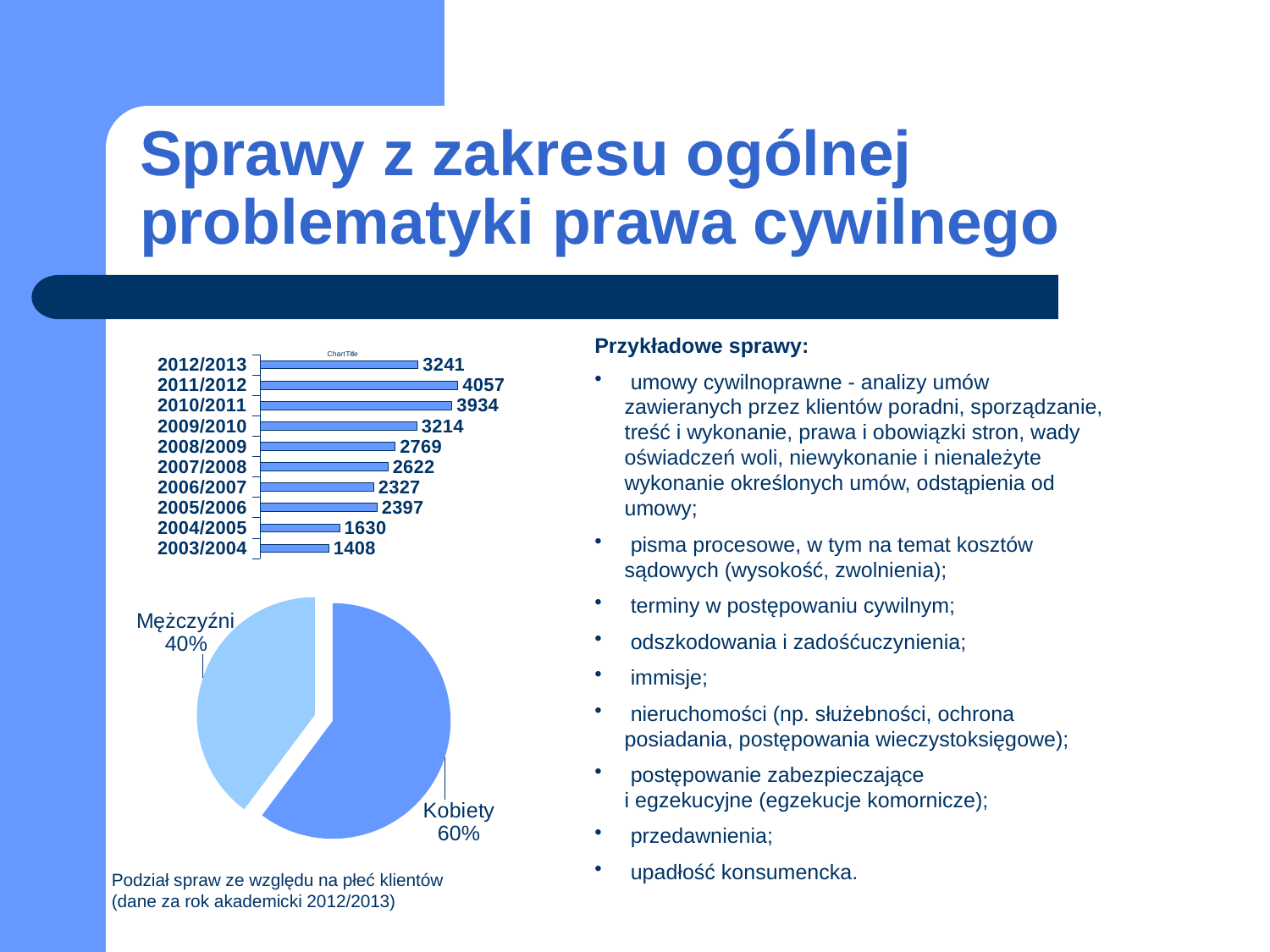
In the bar chart at the top left of the slide, what is the value for 2003/2004? 1408 How many years are shown in the bar chart at the top left of the slide? 10 In the bar chart at the top left of the slide, which is larger, the value for 2005/2006 or the value for 2006/2007? 2005/2006 In the bar chart at the top left of the slide, what is the difference between the values for 2011/2012 and 2012/2013? 816 In the pie chart at the bottom left of the slide, what share is labelled Mężczyźni? 40% In the bar chart at the top left of the slide, what is the value for 2011/2012? 4057 In the pie chart at the bottom left of the slide, what share is labelled Kobiety? 60% How many slices does the pie chart at the bottom left of the slide have? 2 In the bar chart at the top left of the slide, which year has the lowest value? 2003/2004 In the bar chart at the top left of the slide, what is the value for 2008/2009? 2769 In the bar chart at the top left of the slide, which year has the highest value? 2011/2012 What kind of chart is the chart at the top left of the slide? bar chart